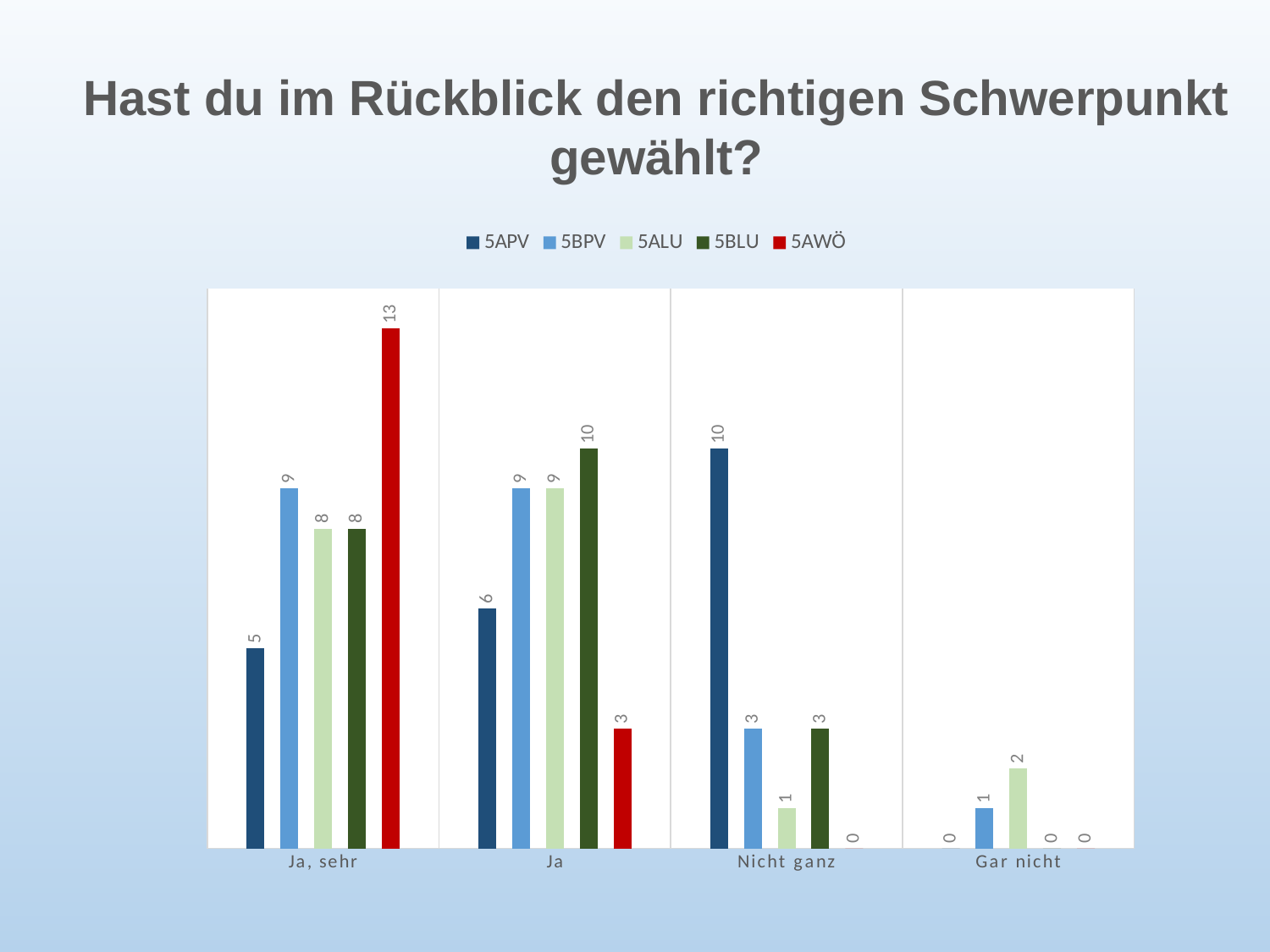
How many categories are shown on the x axis? 4 How many series does the legend list? 5 Which series has the lowest value in the "Ja" category? 5AWÖ In the "Nicht ganz" category, which is larger: the value for 5BPV or the value for 5ALU? 5BPV What is the value for 5ALU in the "Gar nicht" category? 2 What is the title of the slide? Hast du im Rückblick den richtigen Schwerpunkt gewählt? What is the value for 5BLU in the "Ja" category? 10 Which series has the highest value in the "Ja, sehr" category? 5AWÖ What kind of chart is shown on the slide? Bar chart What is the value for 5APV in the "Nicht ganz" category? 10 What is the difference between the 5AWÖ value and the 5APV value in the "Ja, sehr" category? 8 What is the value for 5AWÖ in the "Ja, sehr" category? 13